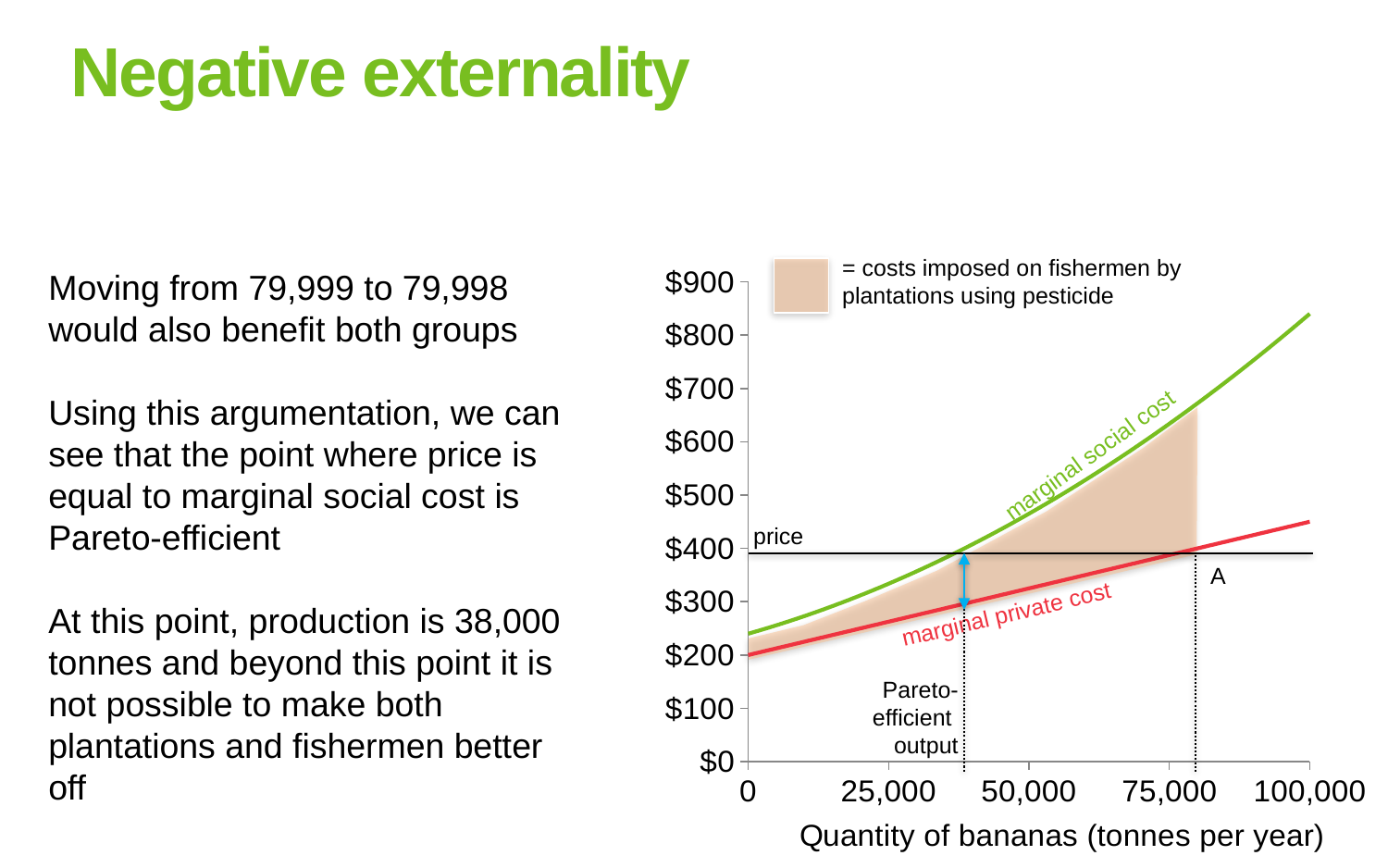
Is the marginal private cost at 100,000 tonnes greater or less than $500? less Is the marginal social cost at a quantity of 0 greater or less than $200? greater At what value is the horizontal price line drawn? $400 Do the marginal social cost and marginal private cost curves rise or fall as quantity increases? rise What kind of chart is shown on the slide? line chart What does the shaded area in the chart represent, according to the legend? costs imposed on fishermen by plantations using pesticide Is the marginal social cost at 50,000 tonnes greater or less than $400? greater Which curve is higher at 75,000 tonnes, marginal social cost or marginal private cost? marginal social cost What is the label of the x axis? Quantity of bananas (tonnes per year) What is the marginal private cost at a quantity of 0? $200